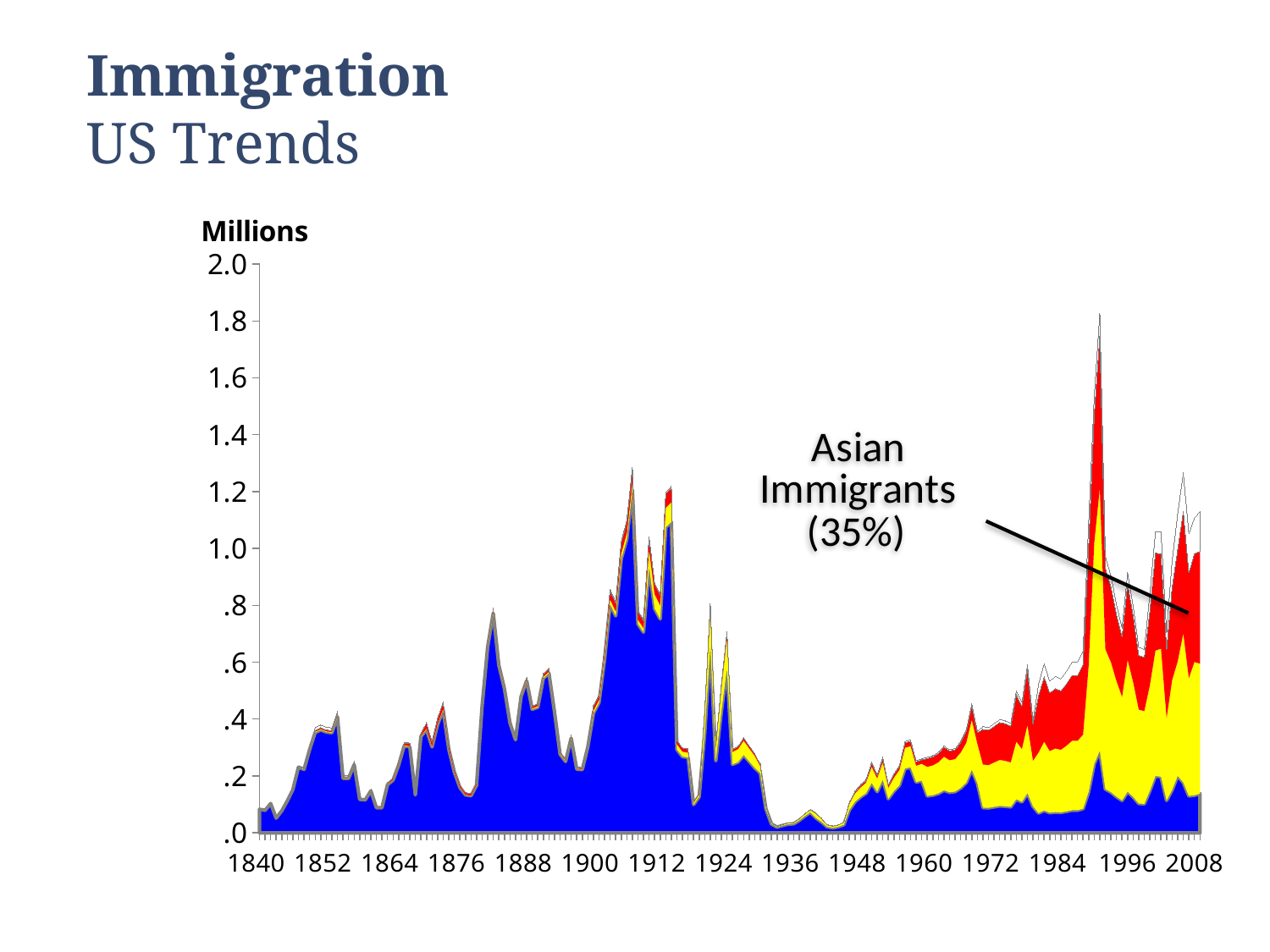
Is the peak total immigration reached between 1984 and 1996 greater or less than 1.6 million? greater Between which two labelled years on the x axis does the chart reach its highest total? 1984 and 1996 What unit is given for the vertical axis of the chart? Millions What kind of chart is shown on the slide? area chart What does the annotation on the chart say about the red area? Asian Immigrants (35%) Is the highest total immigration reached between 1900 and 1912 greater or less than 1.0 million? greater Is the total immigration around 1852 greater or less than .6 million? less Does the total immigration generally rise or fall between 1960 and 1984? rise How many year labels are shown along the x axis? 15 Does the total immigration rise or fall between 1912 and 1936? fall